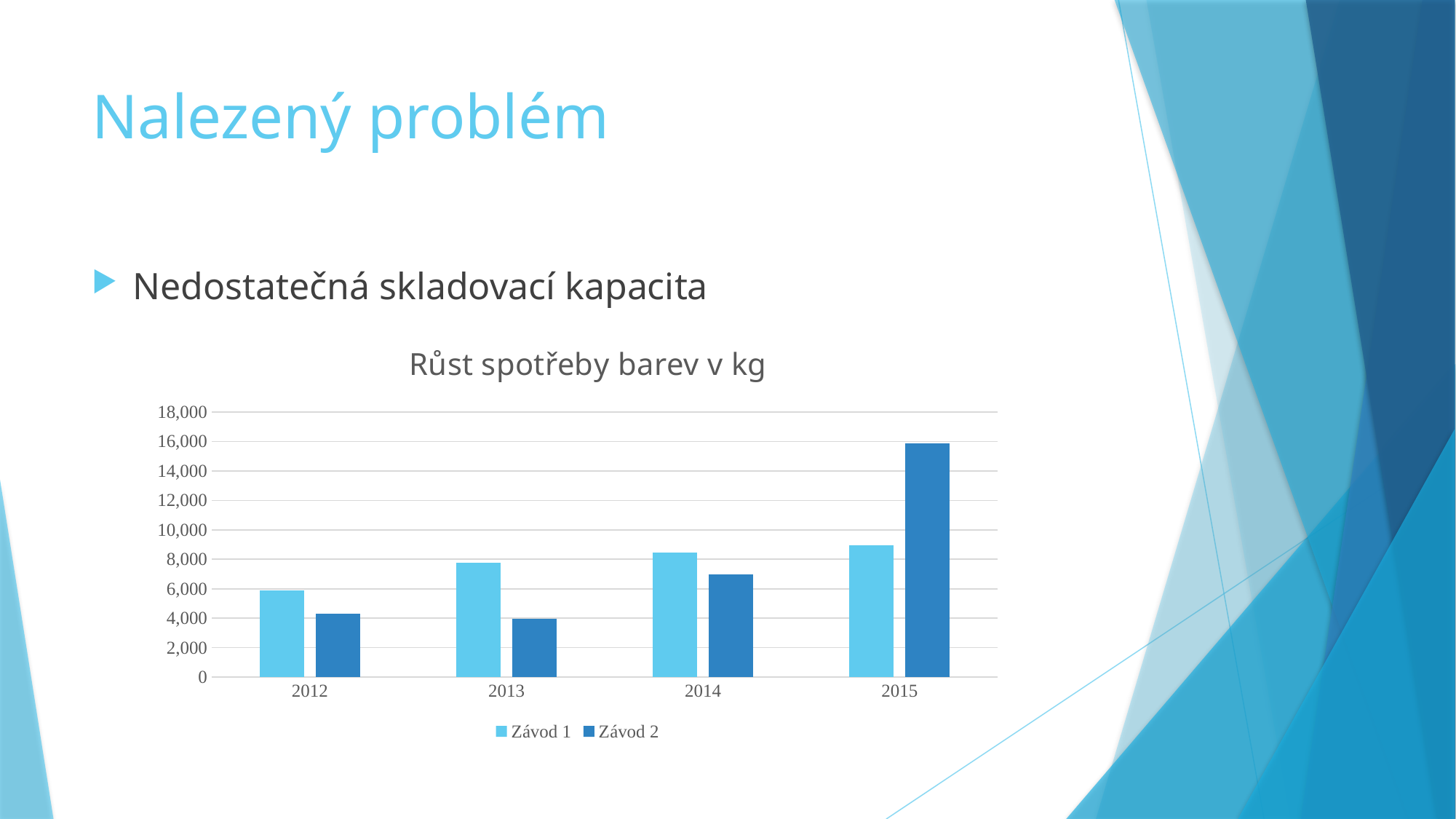
How many series does the legend list? 2 Is the value for Závod 2 in 2014 greater or less than 8,000? less Is the value for Závod 2 in 2015 greater or less than 14,000? greater In 2012, which series has the larger value, Závod 1 or Závod 2? Závod 1 How many years are shown on the x axis of the chart? 4 In 2015, which series has the larger value, Závod 1 or Závod 2? Závod 2 In which year is the value for Závod 2 highest? 2015 In which year is the value for Závod 1 lowest? 2012 What is the title of the chart? Růst spotřeby barev v kg What kind of chart is shown on the slide? bar chart Do the values for Závod 1 rise or fall from 2012 to 2015? rise Is the value for Závod 1 in 2012 greater or less than 4,000? greater